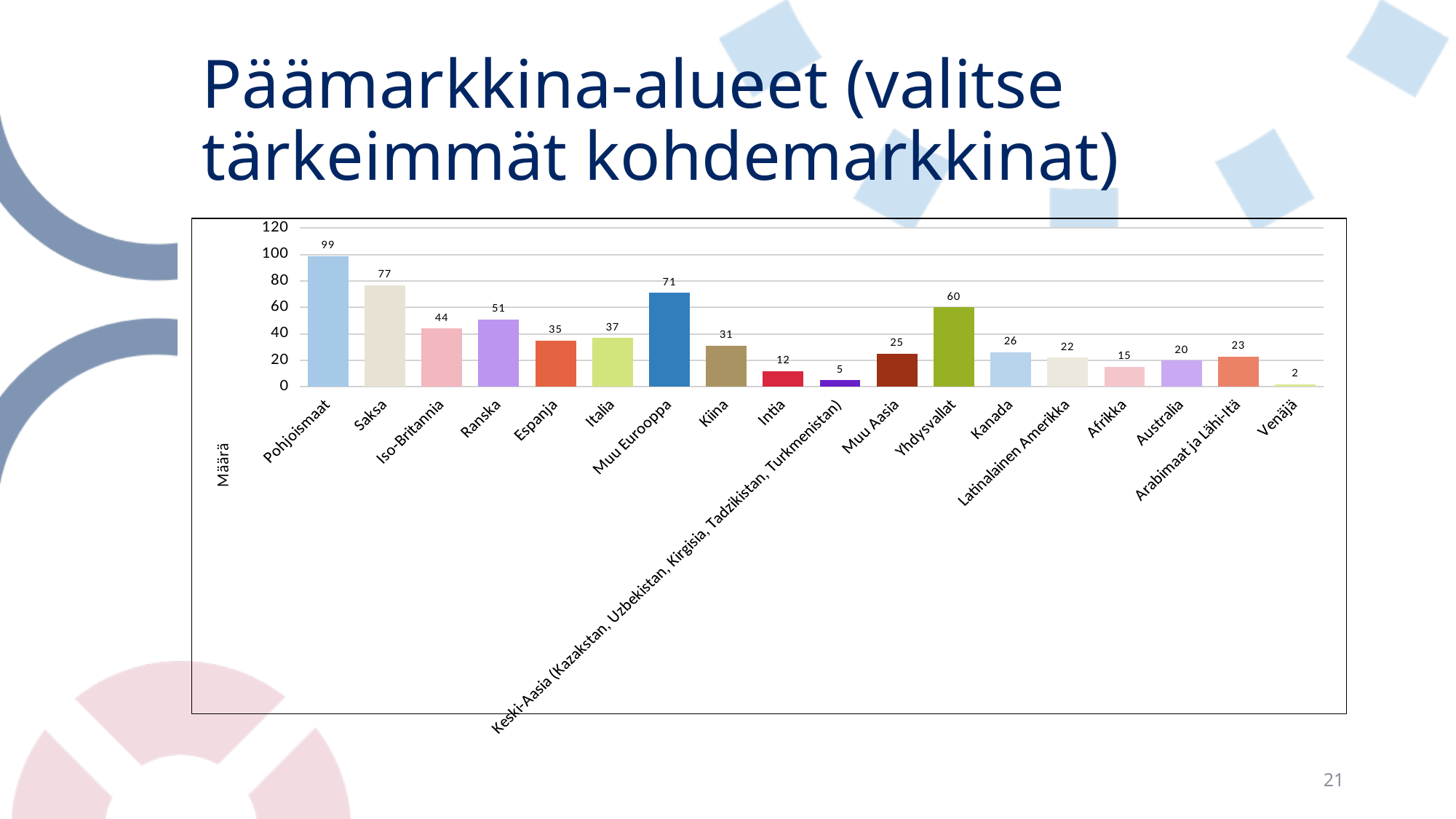
Which is larger, the value for Ranska or the value for Iso-Britannia? Ranska What is the label on the vertical axis? Määrä What is the value for Pohjoismaat? 99 Is the value for Kiina greater or less than 40? less Which category has the lowest value? Venäjä How many categories are shown on the x axis? 18 What is the difference between the values for Saksa and Yhdysvallat? 17 What is the value for Keski-Aasia (Kazakstan, Uzbekistan, Kirgisia, Tadzikistan, Turkmenistan)? 5 What is the value for Arabimaat ja Lähi-Itä? 23 What kind of chart is shown on the slide? bar chart Which category has the highest value? Pohjoismaat What is the value for Muu Eurooppa? 71